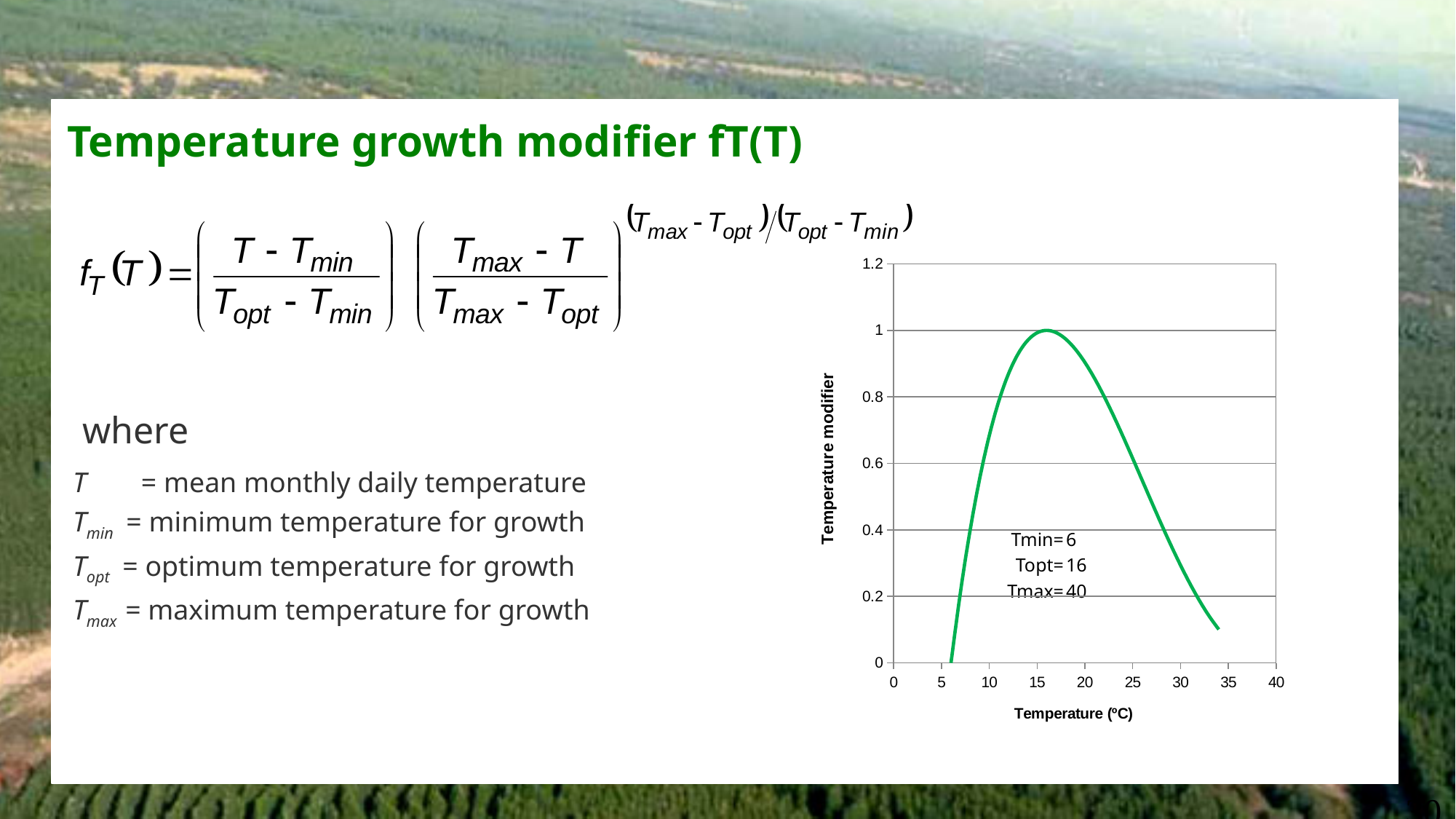
Does the temperature modifier rise or fall as temperature increases from 20 ºC to 34 ºC? fall What is the label of the y axis of the chart? Temperature modifier According to the annotation on the chart, what is the value of Topt? 16 What kind of chart is shown on the slide? line chart What is the label of the x axis of the chart? Temperature (ºC) Which has the larger temperature modifier, 10 ºC or 30 ºC? 10 ºC Is the temperature modifier at 30 ºC greater or less than 0.4? less At what temperature does the curve reach its peak value of 1? 16 According to the annotation on the chart, what is the value of Tmax? 40 Is the temperature modifier at 20 ºC greater or less than 0.8? greater What is the maximum value the temperature modifier reaches on the chart? 1 According to the annotation on the chart, what is the value of Tmin? 6